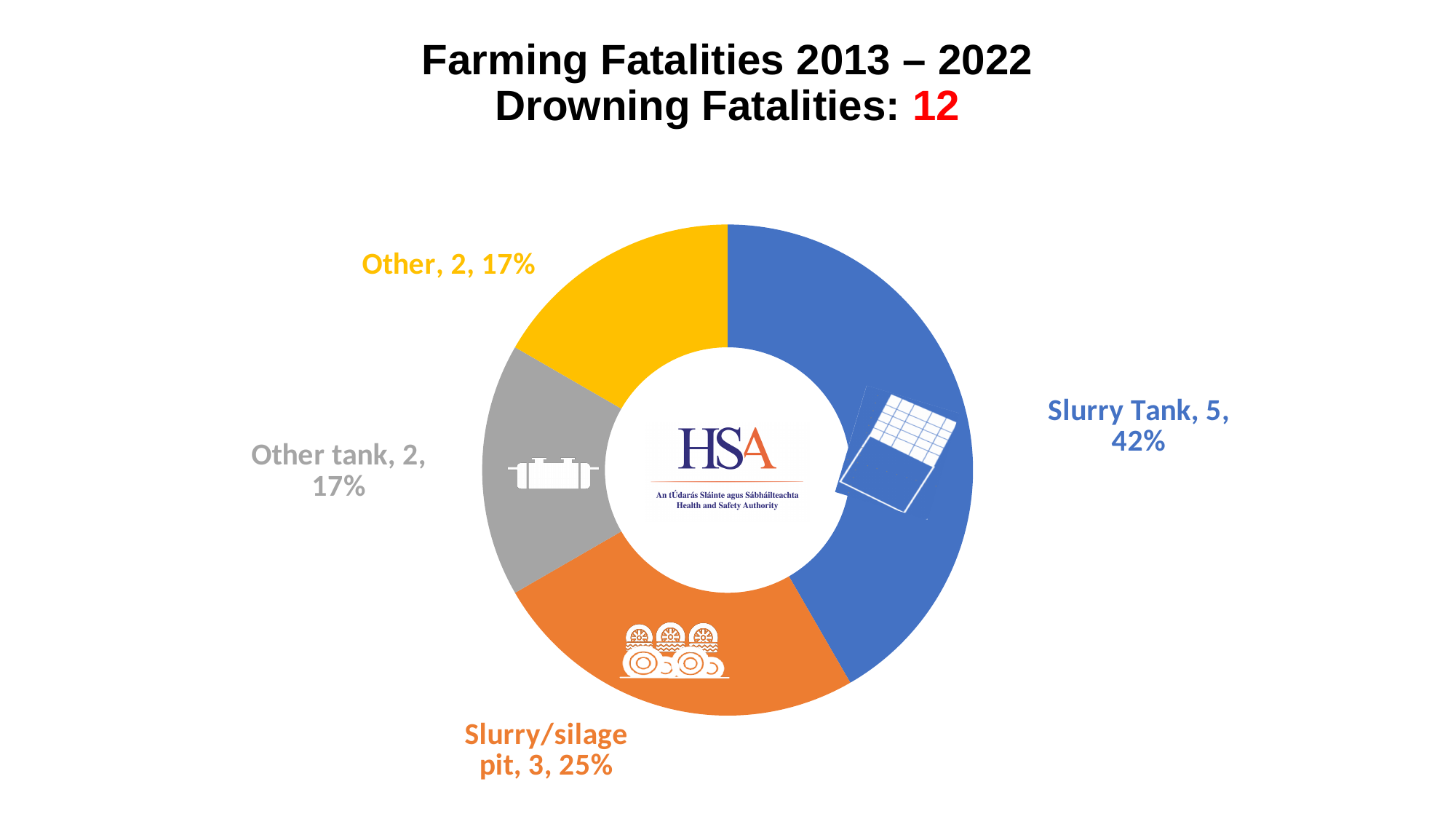
What kind of chart is shown on the slide? Pie chart (doughnut) What share of the pie does the Other category represent? 17% Which category accounts for the largest share of drowning fatalities? Slurry Tank How many drowning fatalities are attributed to Other tank? 2 How many drowning fatalities are attributed to Slurry Tank? 5 What colour is the Slurry Tank slice? Blue How many categories are shown in the chart? 4 What percentage of drowning fatalities is attributed to Slurry/silage pit? 25% What is the difference in fatalities between Slurry Tank and Slurry/silage pit? 2 Which has more fatalities, Slurry/silage pit or Other tank? Slurry/silage pit What is the title of the chart? Farming Fatalities 2013 – 2022 Drowning Fatalities: 12 What is the total number of drowning fatalities shown in the chart? 12